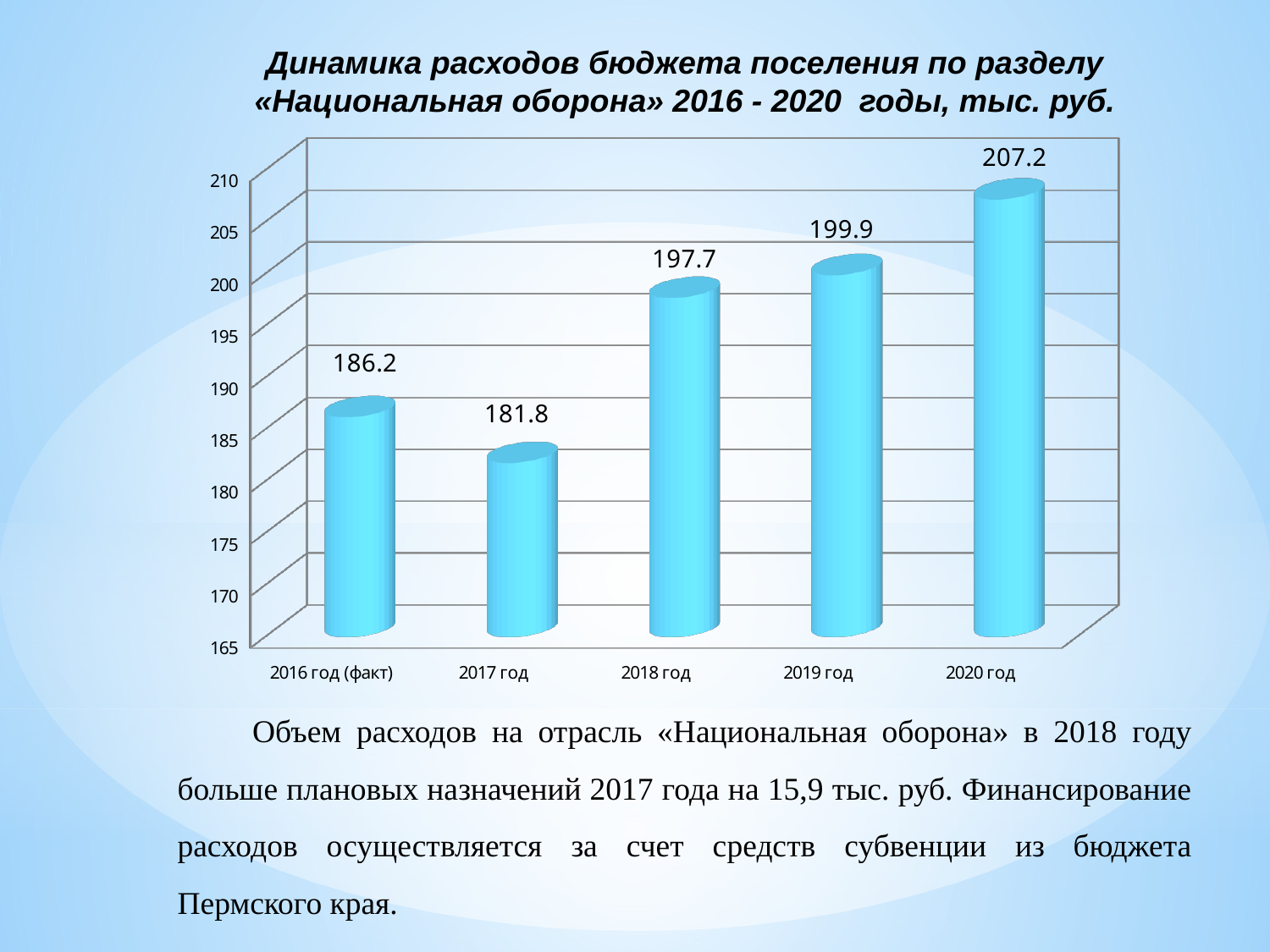
Which year has the lowest value? 2017 год How many bars are shown in the chart? 5 Which is larger, the value for 2016 год (факт) or the value for 2017 год? 2016 год (факт) What kind of chart is shown on the slide? bar chart Which year has the highest value? 2020 год Is the value for 2019 год greater or less than 195? greater What is the difference between the values for 2020 год and 2019 год? 7.3 Do the values rise or fall from 2017 год to 2020 год? rise What is the value for 2020 год? 207.2 What is the value for 2016 год (факт)? 186.2 What is the difference between the values for 2018 год and 2017 год? 15.9 What is the value for 2018 год? 197.7